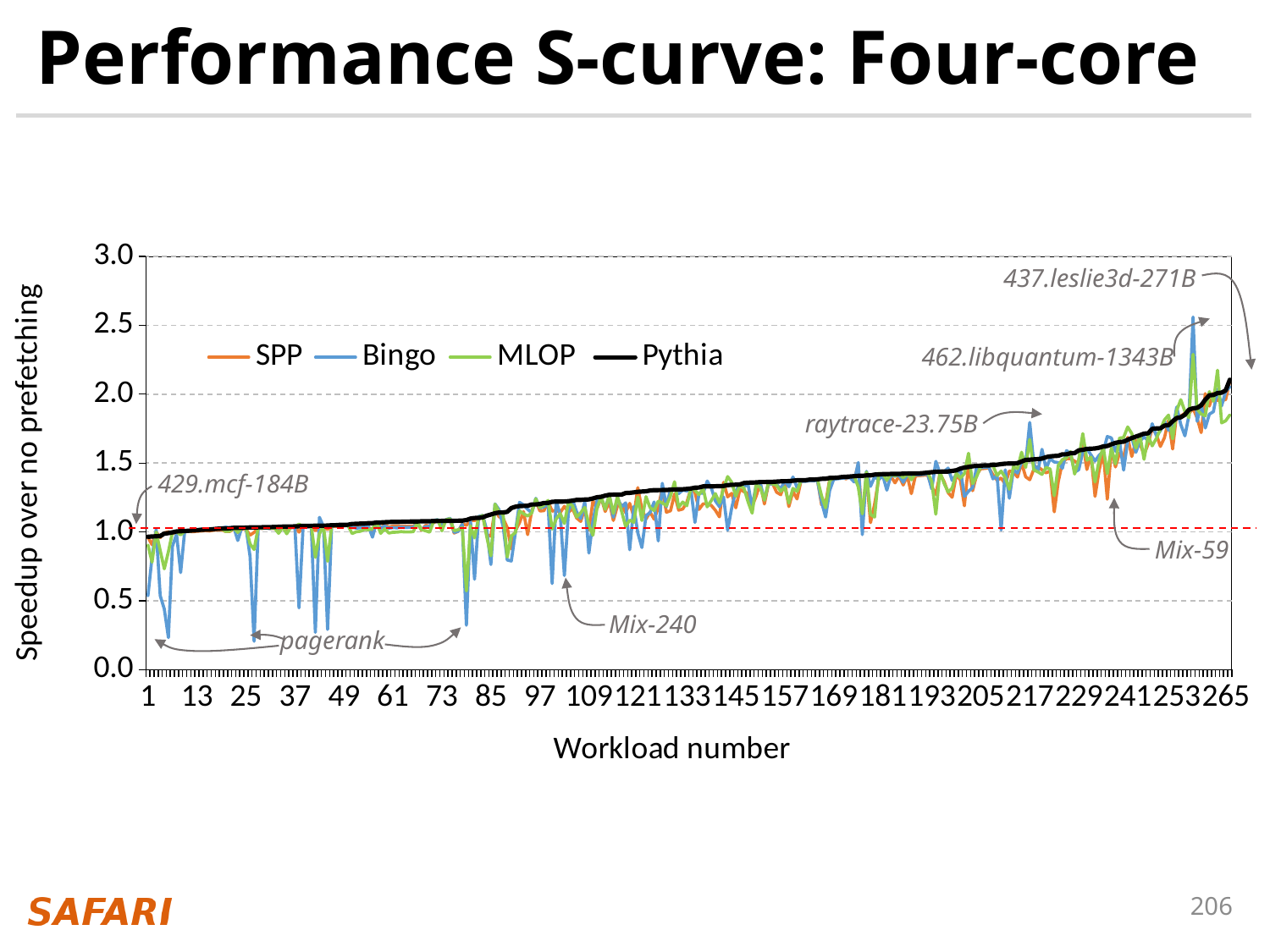
Which series are listed in the legend? SPP, Bingo, MLOP, Pythia Is the Pythia value at workload 133 greater or less than 1.0? greater What kind of chart is shown on the slide? line chart Which series reaches the highest single value on the chart? Bingo Is the Pythia value at workload 265 greater or less than 1.5? greater Is the highest Bingo peak on the chart greater or less than 2.0? greater What is the label of the y axis? Speedup over no prefetching Do the Pythia values rise or fall as the workload number increases along the x axis? rise How many series does the legend list? 4 Which series drops to the lowest value on the chart? Bingo At workload 265, which is higher, Pythia or MLOP? Pythia